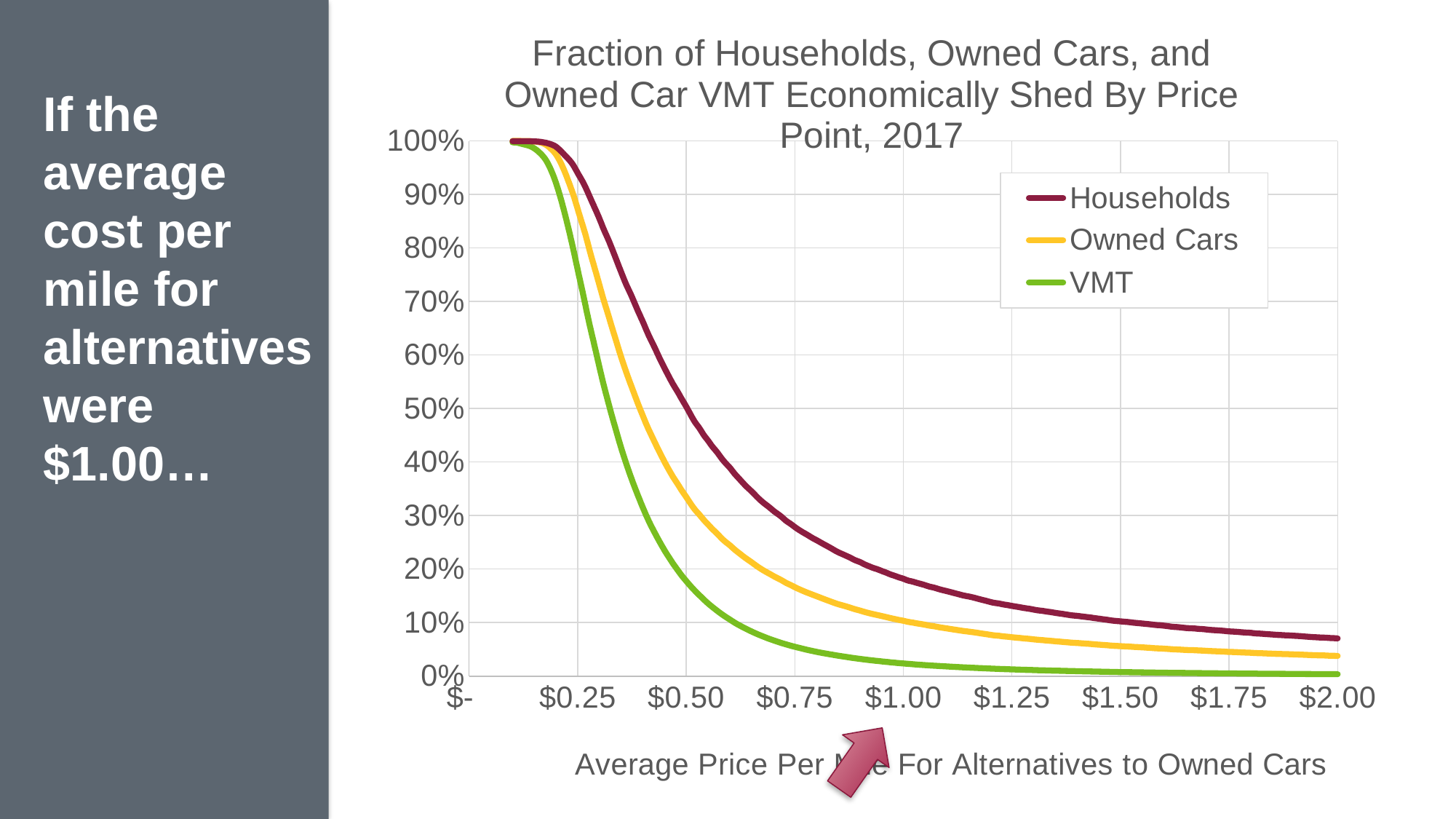
Is the value for VMT at $0.50 greater or less than 30%? less What kind of chart is shown on the slide? line chart Is the value for Households at $1.00 greater or less than 10%? greater At $1.00, which series has the larger value, Households or VMT? Households How many series does the legend list? 3 Is the value for Households at $2.00 greater or less than 10%? less Which series are listed in the legend? Households, Owned Cars, VMT What is the label of the x axis? Average Price Per Mile For Alternatives to Owned Cars Do the values for Households rise or fall as the price per mile increases along the x axis? fall Which series has the lowest value at $1.50? VMT